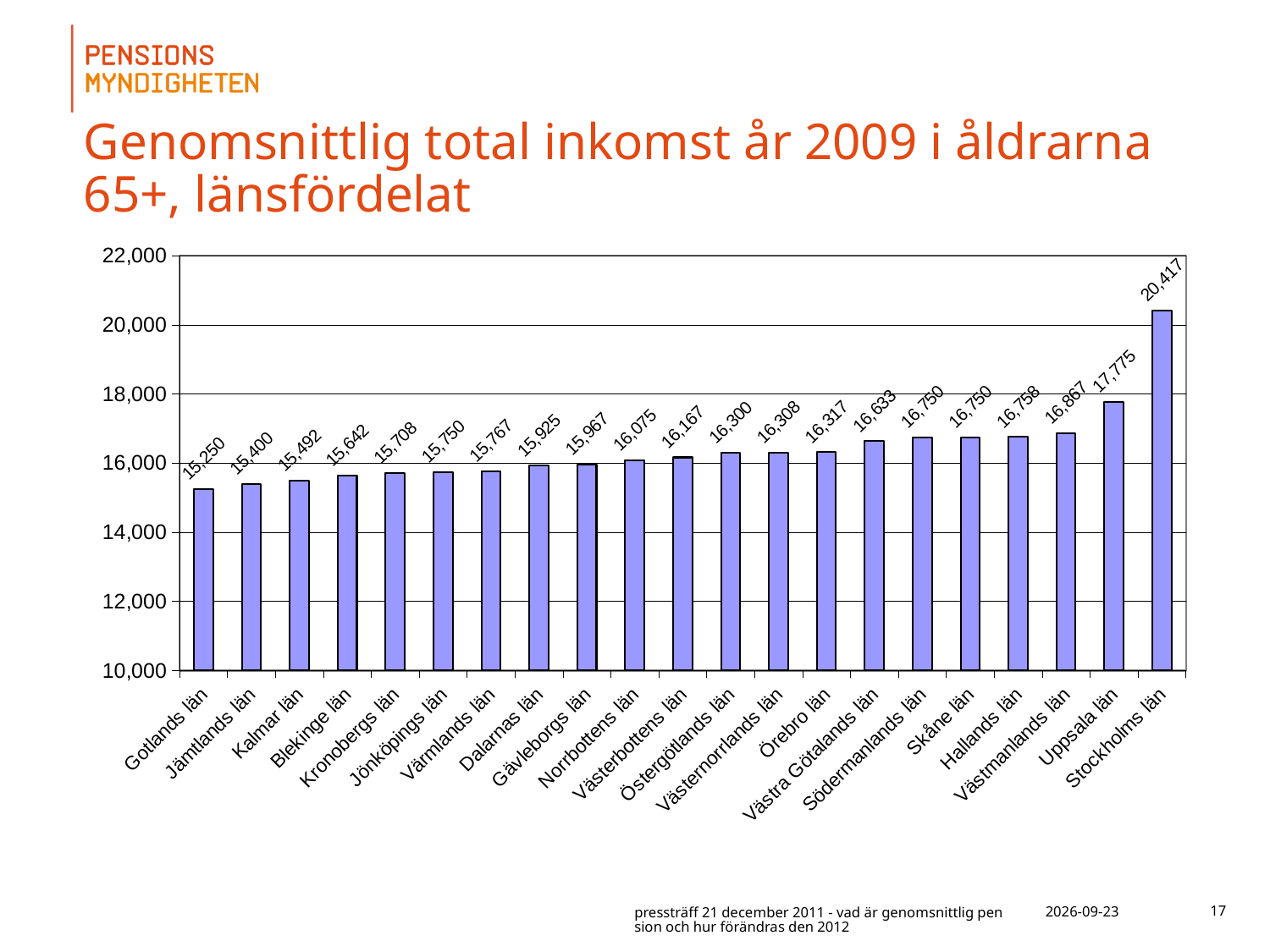
What is the value for Stockholms län? 20,417 What is the difference between the values for Stockholms län and Uppsala län? 2,642 What kind of chart is shown on the slide? bar chart What is the difference between the values for Jämtlands län and Gotlands län? 150 Which is larger, the value for Dalarnas län or the value for Norrbottens län? Norrbottens län Which county has the highest value? Stockholms län What is the value for Uppsala län? 17,775 What is the value for Västra Götalands län? 16,633 Is the value for Västmanlands län greater or less than 18,000? less What is the value for Gotlands län? 15,250 How many counties are shown on the chart? 21 Which county has the lowest value? Gotlands län